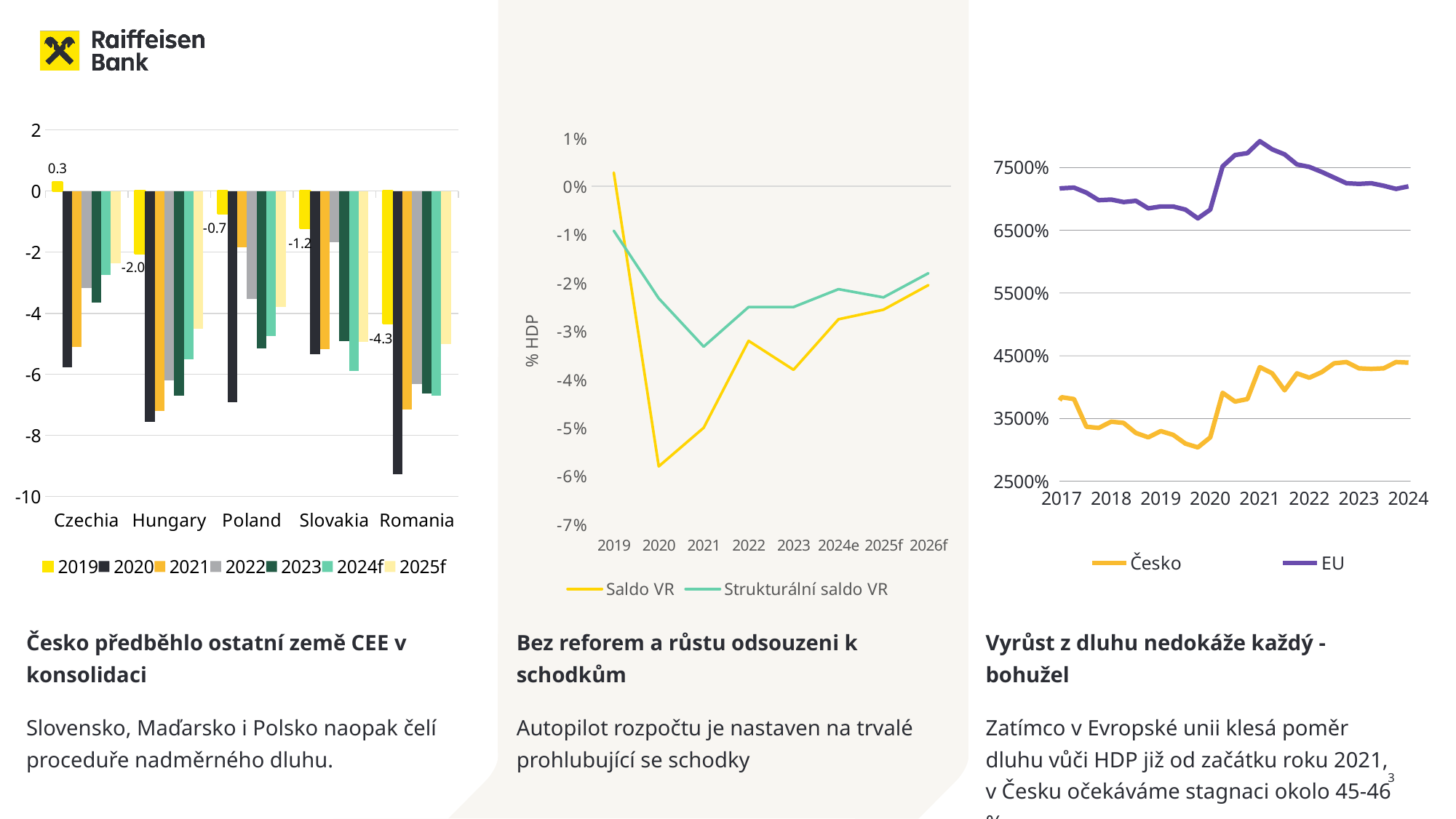
In the middle line chart, is the value of Saldo VR in 2020 greater or less than -5%? less How many series does the legend of the left bar chart list? 7 In the right line chart, which series is higher in 2021, Česko or EU? EU In the middle line chart, which series is higher in 2020, Saldo VR or Strukturální saldo VR? Strukturální saldo VR What kind of chart is the left chart with the countries Czechia, Hungary, Poland, Slovakia and Romania? bar chart What is the y-axis label of the middle line chart? % HDP In the left bar chart, which country has the lowest value for 2020? Romania In the left bar chart, what is the difference between the 2019 values for Czechia and Hungary? 2.3 How many countries are shown on the x axis of the left bar chart? 5 In the left bar chart, what is the value for Romania in 2019? -4.3 In the left bar chart, what is the value for Czechia in 2019? 0.3